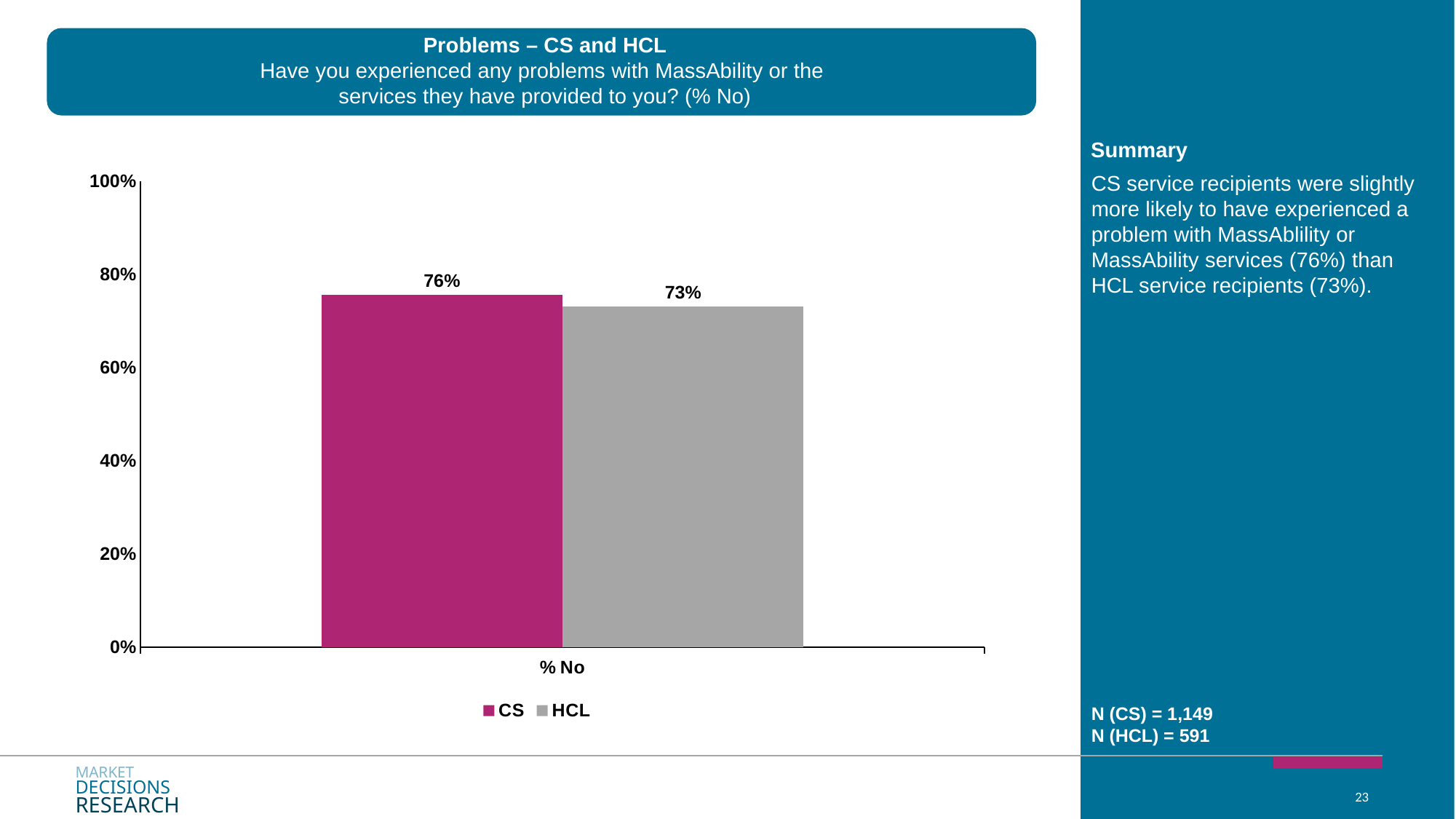
Which series has the higher value, CS or HCL? CS What colour is the bar for CS? magenta What is the value for CS in the chart? 76% What is the category label on the x axis of the chart? % No What is the highest value shown on the y axis of the chart? 100% Which series has the lowest value in the chart? HCL Is the value for CS greater or less than 60%? greater Is the value for HCL greater or less than 80%? less How many series does the legend list? 2 What is the value for HCL in the chart? 73% What is the difference between the CS and HCL values? 3% What kind of chart is shown on the slide? bar chart